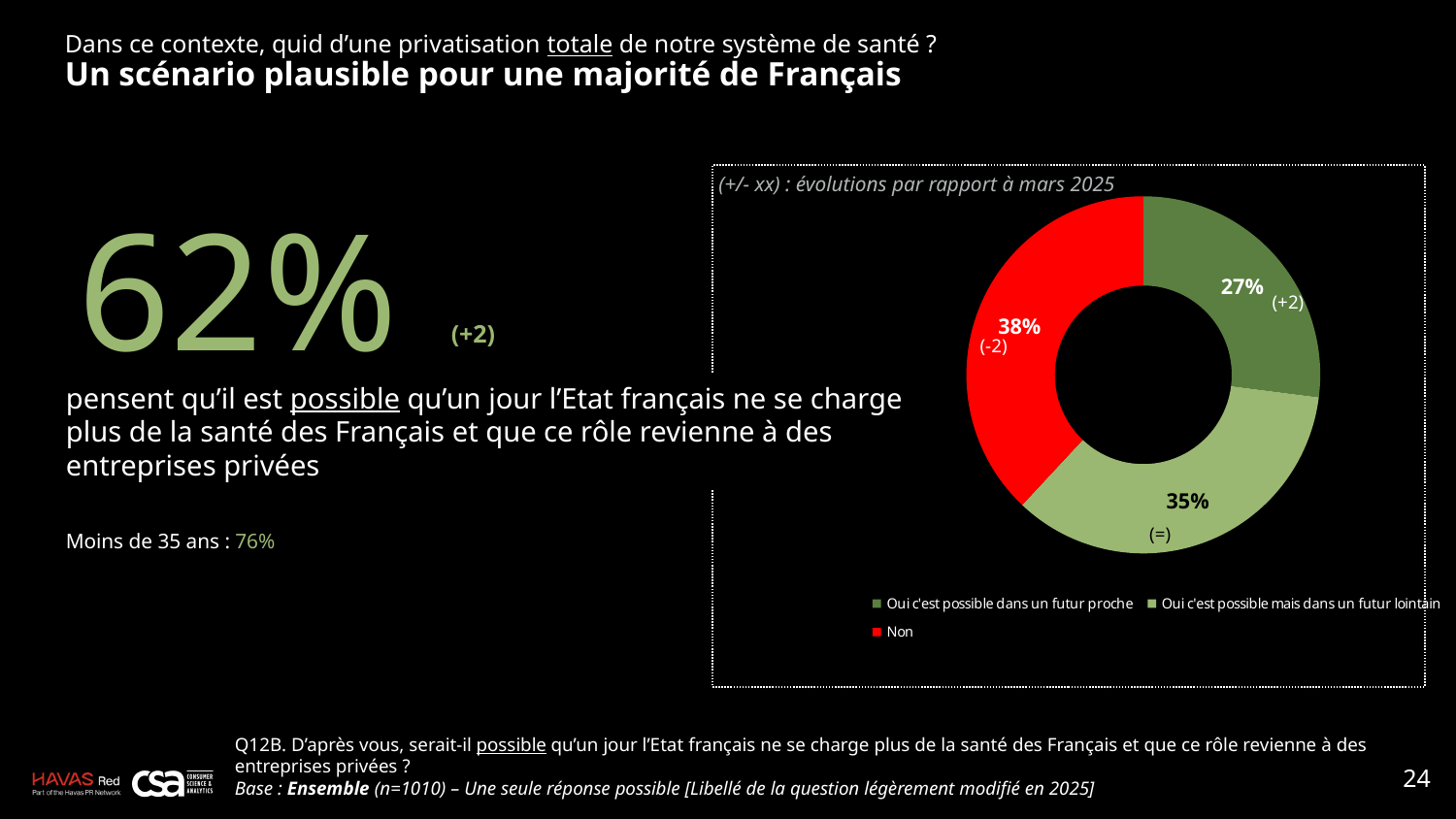
What percentage of respondents answered "Non"? 38% What is the difference in percentage points between "Non" and "Oui c'est possible dans un futur proche"? 11 Which is larger: the share for "Non" or the share for "Oui c'est possible mais dans un futur lointain"? Non Which response has the largest share of the pie? Non What percentage of respondents answered "Oui c'est possible mais dans un futur lointain"? 35% Which response has the smallest share of the pie? Oui c'est possible dans un futur proche What type of chart is shown on the slide? Pie chart (donut) How many entries does the legend list? 3 What percentage of respondents answered "Oui c'est possible dans un futur proche"? 27% How many slices does the pie chart have? 3 What colour is the "Non" slice in the pie chart? Red What is the change compared to March 2025 shown for the "Non" slice? -2